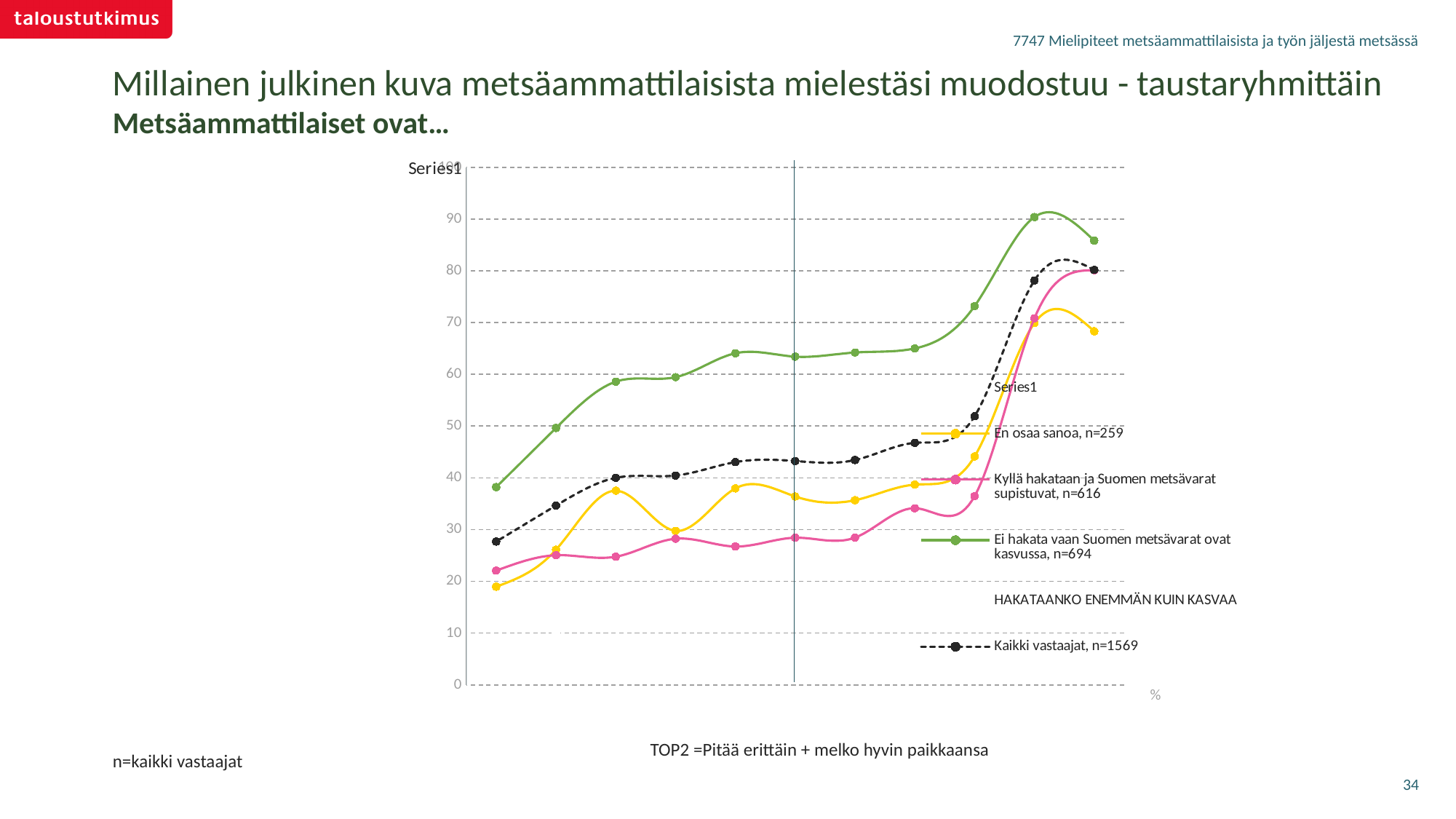
Is the first (leftmost) value of the pink 'Kyllä hakataan ja Suomen metsävarat supistuvat' line greater or less than 20? greater At the rightmost point, which is larger: the green 'Ei hakata vaan...' line or the yellow 'En osaa sanoa' line? Ei hakata vaan Suomen metsävarat ovat kasvussa, n=694 What kind of chart is shown on the slide? line chart Which series has the lowest value at the rightmost point of the chart? En osaa sanoa, n=259 Is the last (rightmost) value of the green 'Ei hakata vaan Suomen metsävarat ovat kasvussa' line greater or less than 80? greater How many data points does the green line 'Ei hakata vaan Suomen metsävarat ovat kasvussa, n=694' have? 11 Does the green 'Ei hakata vaan Suomen metsävarat ovat kasvussa' line generally rise or fall from left to right? rise Is the first (leftmost) value of the black dashed 'Kaikki vastaajat, n=1569' line greater or less than 30? less Which series reaches the highest value anywhere in the chart? Ei hakata vaan Suomen metsävarat ovat kasvussa, n=694 What unit is shown at the bottom right of the chart's axis? % What line style is used for the 'Kaikki vastaajat, n=1569' series? black dashed line How many respondent-group lines (with n values) are plotted in the chart? 4